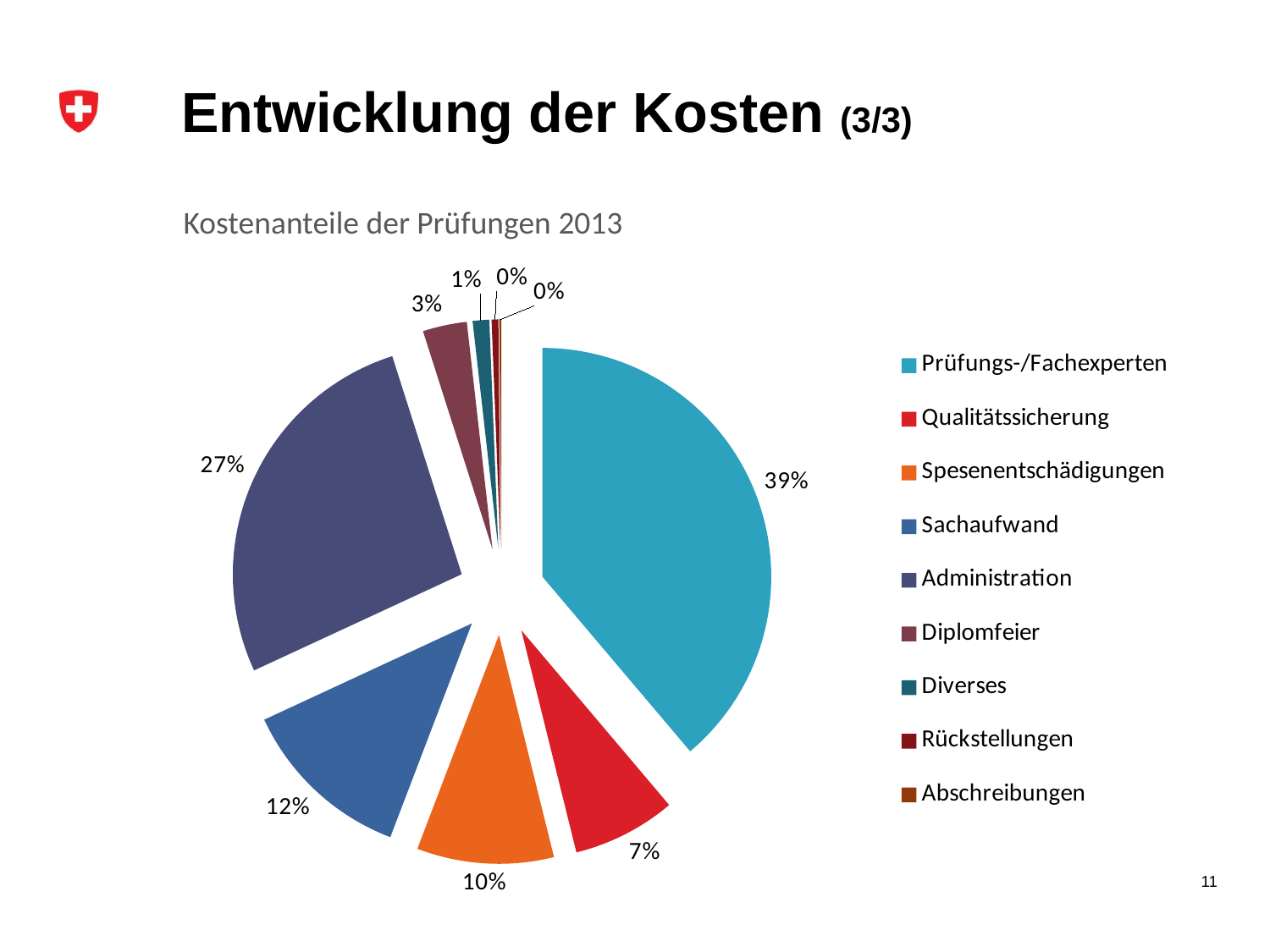
What is the title of the chart? Kostenanteile der Prüfungen 2013 What kind of chart is shown on the slide? pie chart What share of the pie is Sachaufwand? 12% Which category has the largest share of the pie? Prüfungs-/Fachexperten What share of the pie is Spesenentschädigungen? 10% What is the difference between the share for Prüfungs-/Fachexperten and the share for Administration? 12% What share of the pie is Prüfungs-/Fachexperten? 39% How many entries does the legend list? 9 Which is larger, the share for Sachaufwand or the share for Spesenentschädigungen? Sachaufwand